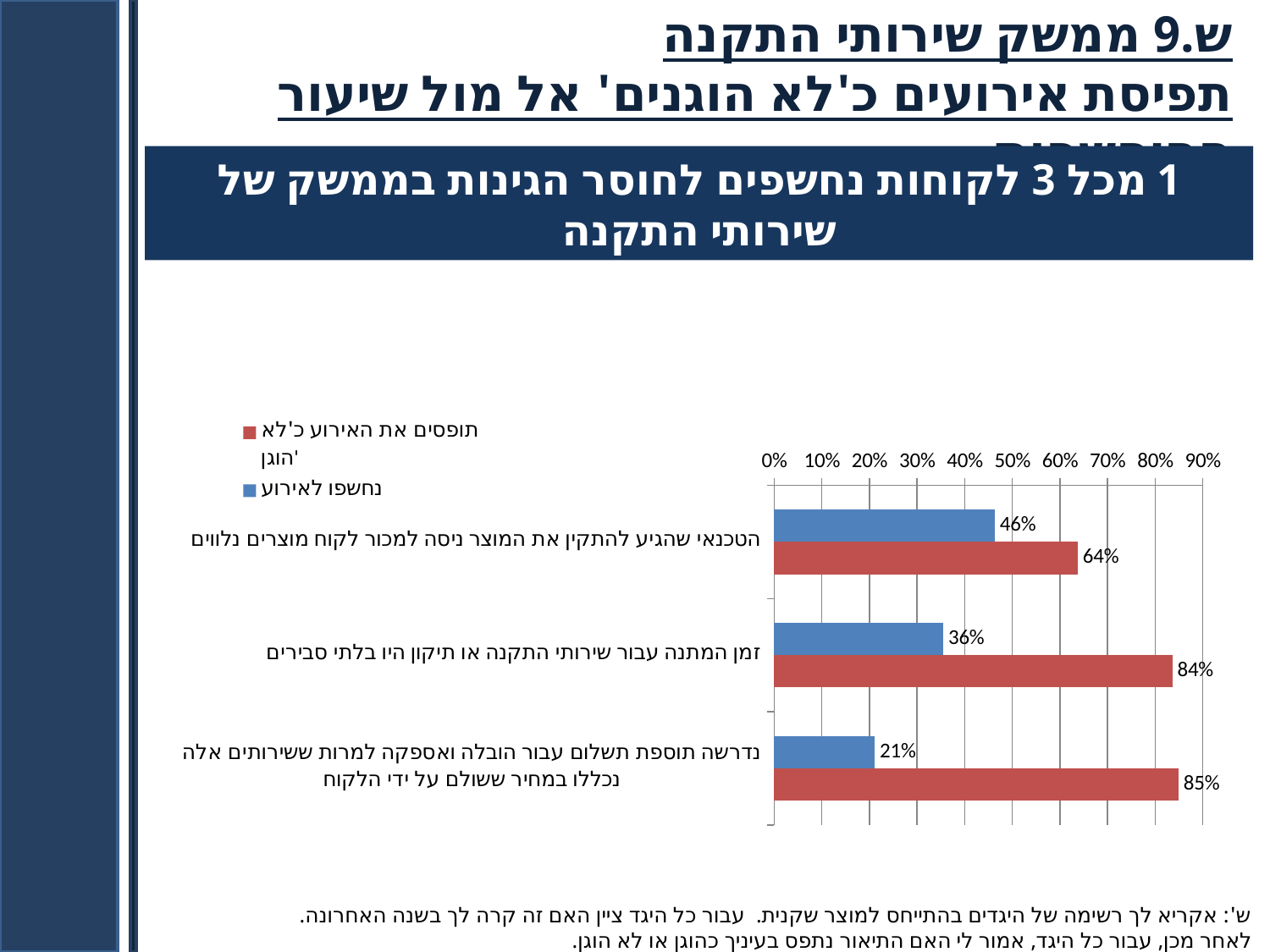
What is the value of the 'נחשפו לאירוע' series for the category 'נדרשה תוספת תשלום עבור הובלה ואספקה למרות ששירותים אלה נכללו במחיר ששולם על ידי הלקוח'? 21% Which colour represents the 'נחשפו לאירוע' series in the chart? blue What is the value of the 'תופסים את האירוע כ'לא הוגן'' series for the category 'זמן המתנה עבור שירותי התקנה או תיקון היו בלתי סבירים'? 84% Is the 'נחשפו לאירוע' value for 'זמן המתנה עבור שירותי התקנה או תיקון היו בלתי סבירים' greater or less than 40%? less What type of chart is shown on the slide? bar chart What is the value of the 'נחשפו לאירוע' series for the category 'הטכנאי שהגיע להתקין את המוצר ניסה למכור לקוח מוצרים נלווים'? 46% How many series does the chart legend list? 2 For the category 'הטכנאי שהגיע להתקין את המוצר ניסה למכור לקוח מוצרים נלווים', which series has the larger value? תופסים את האירוע כ'לא הוגן' How many categories are plotted in the chart? 3 Which category has the highest value in the 'תופסים את האירוע כ'לא הוגן'' series? נדרשה תוספת תשלום עבור הובלה ואספקה למרות ששירותים אלה נכללו במחיר ששולם על ידי הלקוח What is the difference between the 'תופסים את האירוע כ'לא הוגן'' value and the 'נחשפו לאירוע' value for the category 'זמן המתנה עבור שירותי התקנה או תיקון היו בלתי סבירים'? 48% Which category has the lowest value in the 'נחשפו לאירוע' series? נדרשה תוספת תשלום עבור הובלה ואספקה למרות ששירותים אלה נכללו במחיר ששולם על ידי הלקוח